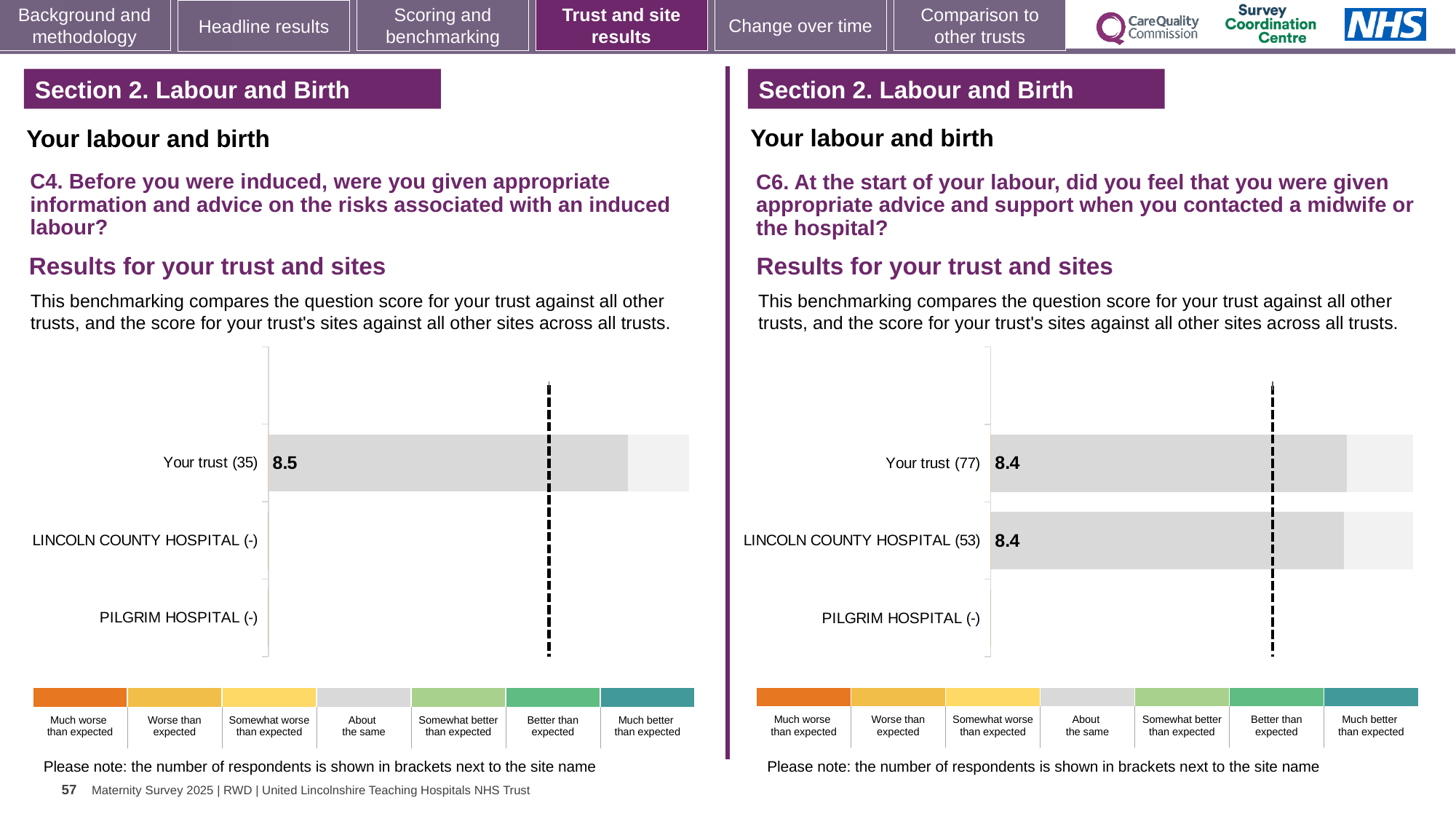
In the left chart (C4), how many respondents are shown in brackets for Your trust? 35 In the right chart (C6), how many respondents are shown in brackets for LINCOLN COUNTY HOSPITAL? 53 In the right chart (C6), which site has no score bar shown? PILGRIM HOSPITAL How many categories (rows) are listed on the left chart (C4)? 3 In the right chart (C6), how many respondents are shown in brackets for Your trust? 77 What kind of chart is used on the right (C6)? Bar chart In the right chart (C6), what is the score for Your trust? 8.4 In the left chart (C4), what is the score for Your trust? 8.5 What is the difference between the Your trust score in the left chart (C4) and the Your trust score in the right chart (C6)? 0.1 In the right chart (C6), what is the score for LINCOLN COUNTY HOSPITAL? 8.4 Which is larger: the Your trust score in the left chart (C4) or the Your trust score in the right chart (C6)? Left chart (C4), 8.5 How many colour categories are shown in the key below the left chart (C4)? 7